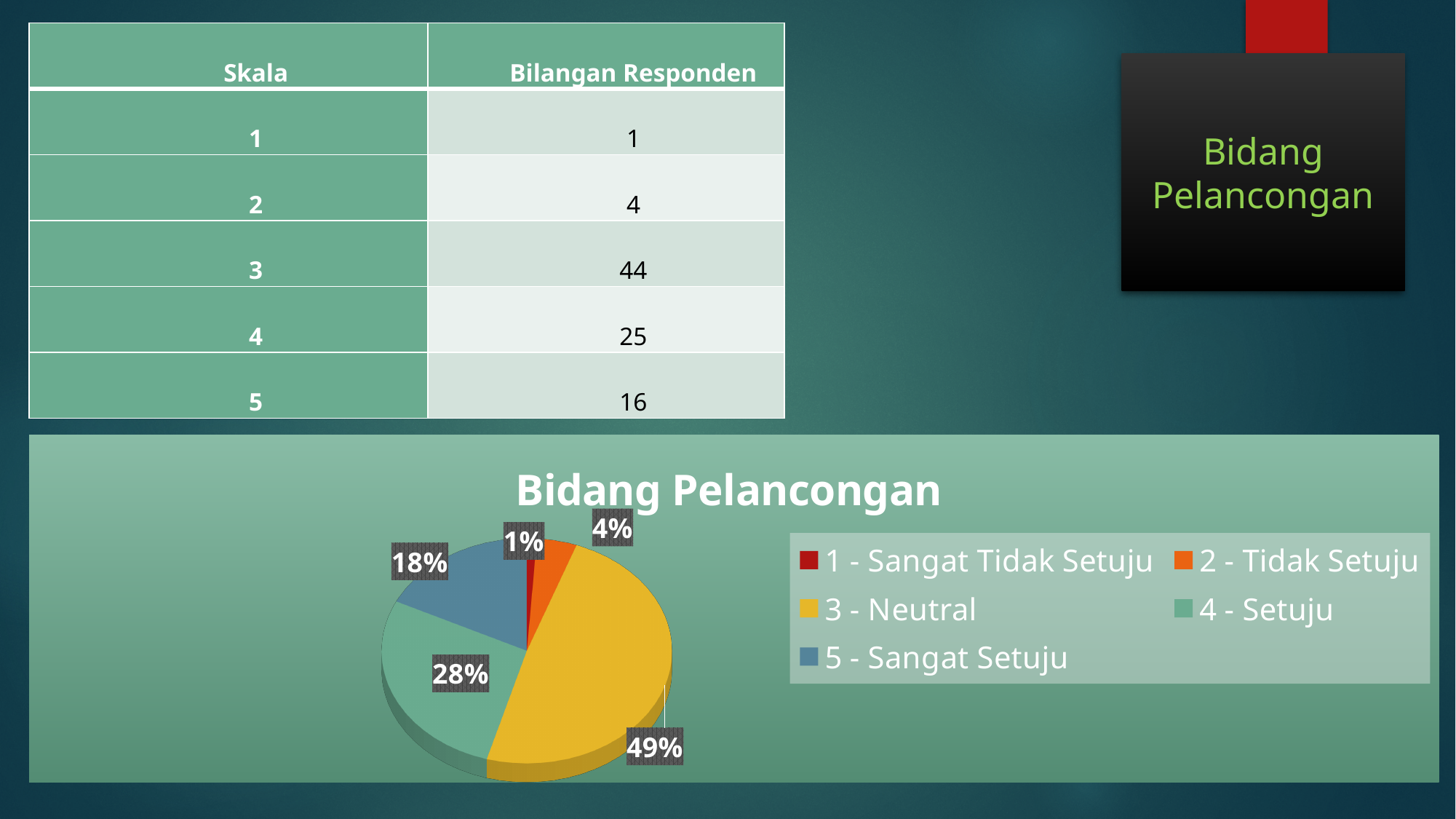
What share of the pie does the '4 - Setuju' slice have? 28% Which category has the smallest slice of the pie? 1 - Sangat Tidak Setuju What kind of chart is shown on the slide? pie chart What share of the pie does the '3 - Neutral' slice have? 49% How many slices does the pie chart have? 5 What share of the pie does the '5 - Sangat Setuju' slice have? 18% Which slice is larger, '4 - Setuju' or '5 - Sangat Setuju'? 4 - Setuju Which category has the largest slice of the pie? 3 - Neutral What is the title of the chart? Bidang Pelancongan What is the difference in percentage points between the '3 - Neutral' slice and the '4 - Setuju' slice? 21%